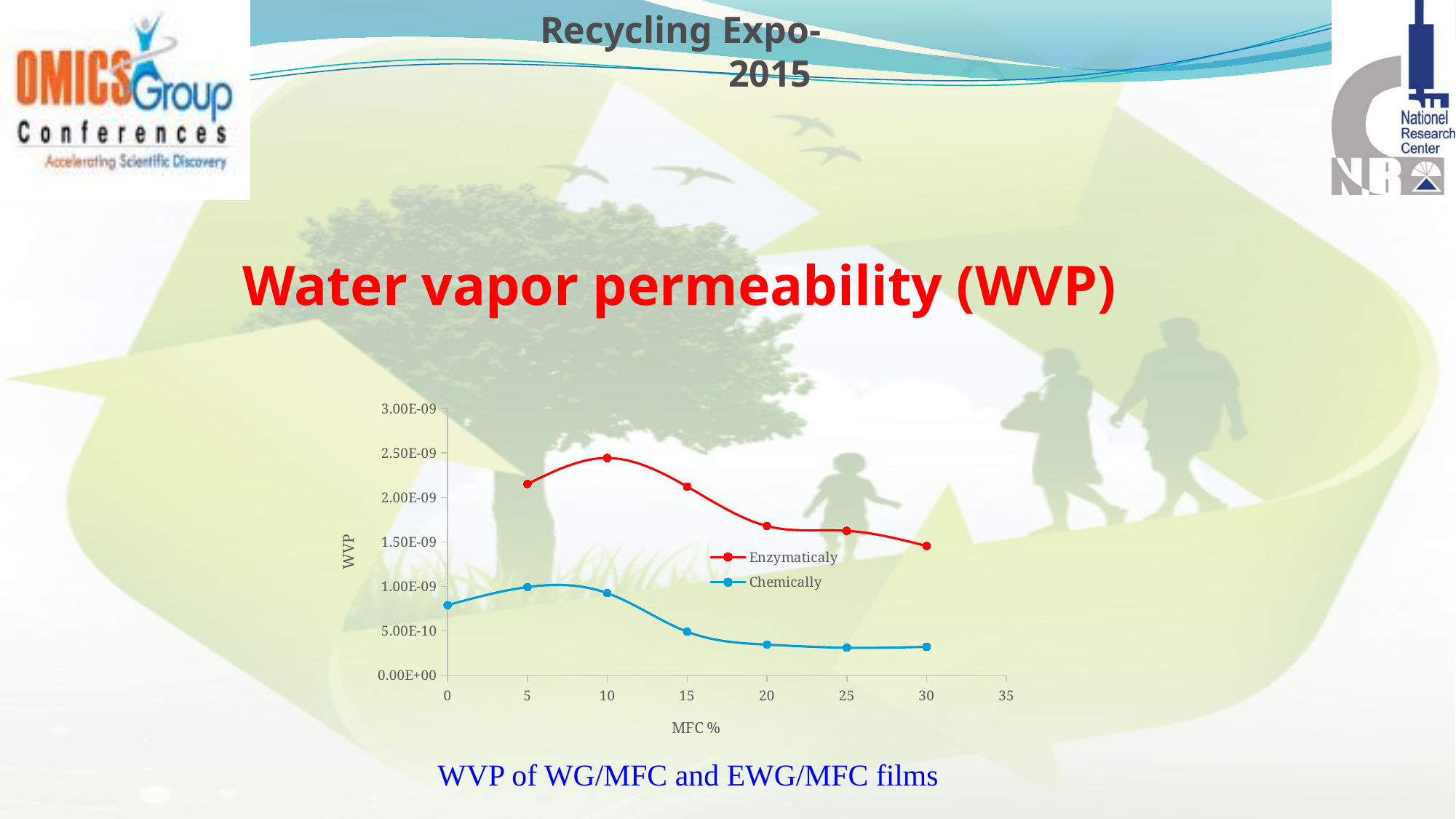
Is the Enzymaticaly value at MFC 10% greater or less than 2.00E-09? greater What is the x-axis title of the chart? MFC % How many series does the legend list? 2 At MFC 30%, which series has the higher WVP, Enzymaticaly or Chemically? Enzymaticaly What kind of chart is shown on the slide? line chart At which MFC % does the Enzymaticaly series reach its highest WVP value? 10 At which MFC % does the Enzymaticaly series reach its lowest WVP value? 30 Does the Enzymaticaly series rise or fall from MFC 10% to MFC 30%? fall Is the Enzymaticaly value at MFC 30% greater or less than 1.00E-09? greater What are the two series named in the legend? Enzymaticaly and Chemically How many data points are plotted for the Chemically series? 7 Is the Chemically value at MFC 30% greater or less than 5.00E-10? less